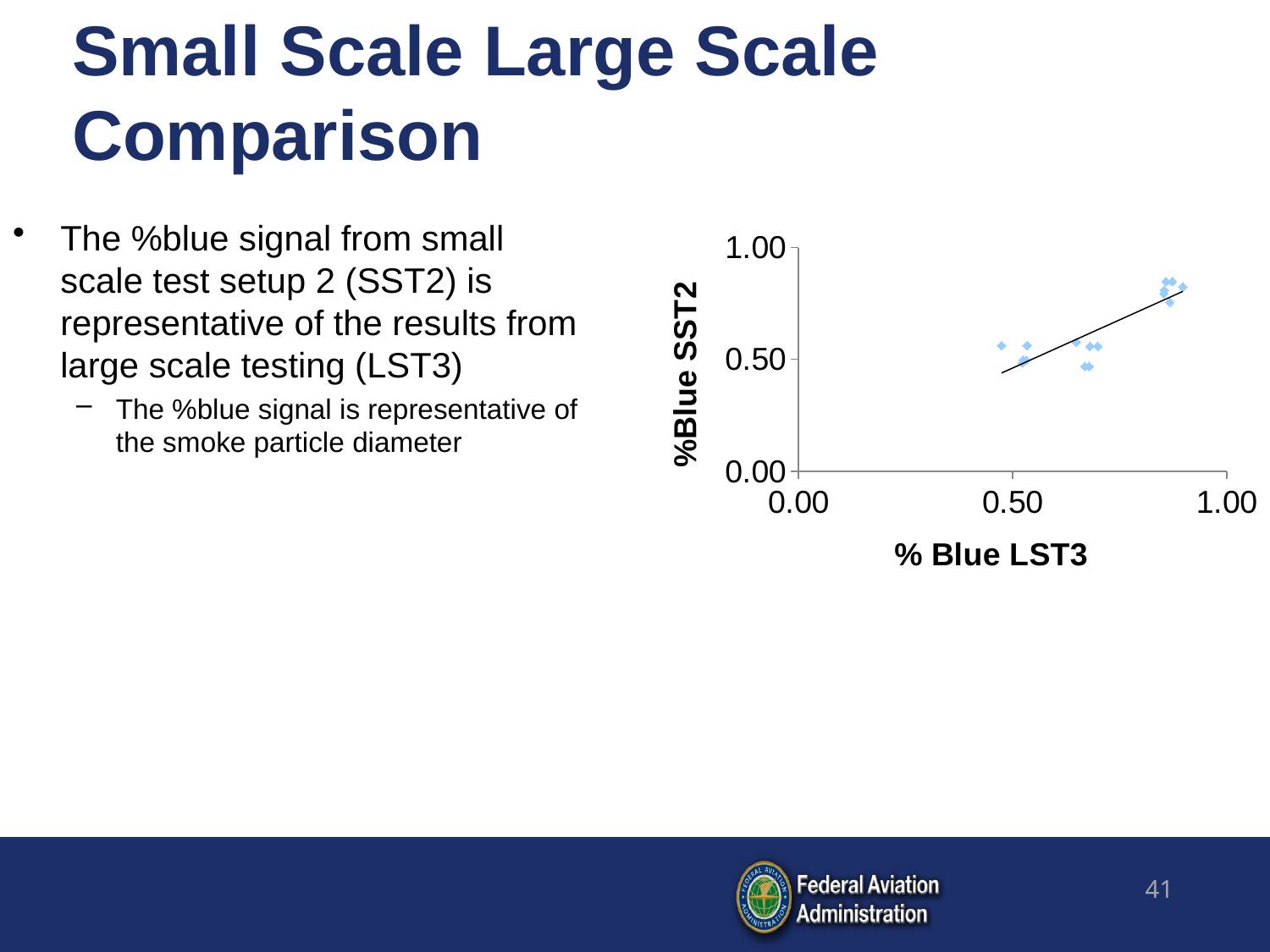
What is the maximum tick value shown on the y axis of the chart? 1.00 Is the highest plotted %Blue SST2 value greater or less than 1.00? less Is the largest plotted % Blue LST3 value greater or less than 0.50? greater Is the highest plotted %Blue SST2 value greater or less than 0.50? greater What kind of chart is shown on the slide? scatter chart What is the label of the x axis of the chart? % Blue LST3 What is the label of the y axis of the chart? %Blue SST2 Do the plotted %Blue SST2 values generally rise or fall as % Blue LST3 increases? rise